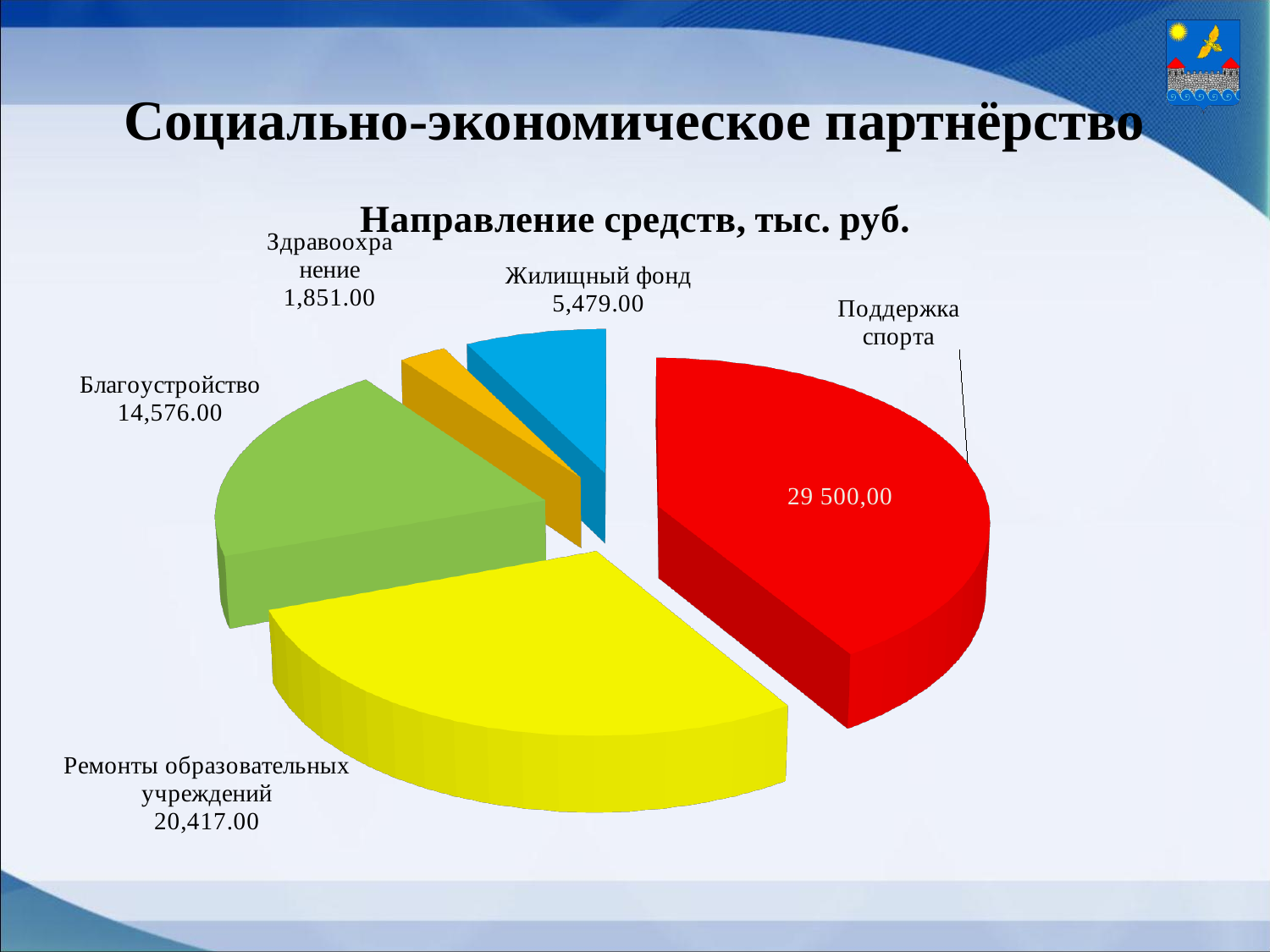
What is the title of the chart? Направление средств, тыс. руб. What is the value for Поддержка спорта? 29 500,00 What is the difference between the values for Поддержка спорта and Ремонты образовательных учреждений? 9,083.00 What is the value for Ремонты образовательных учреждений? 20,417.00 Which is larger, Благоустройство or Жилищный фонд? Благоустройство What is the value for Жилищный фонд? 5,479.00 How many slices does the pie chart have? 5 Which category has the largest value? Поддержка спорта What is the value for Благоустройство? 14,576.00 What is the value for Здравоохранение? 1,851.00 Which category has the smallest value? Здравоохранение What kind of chart is shown on the slide? Pie chart